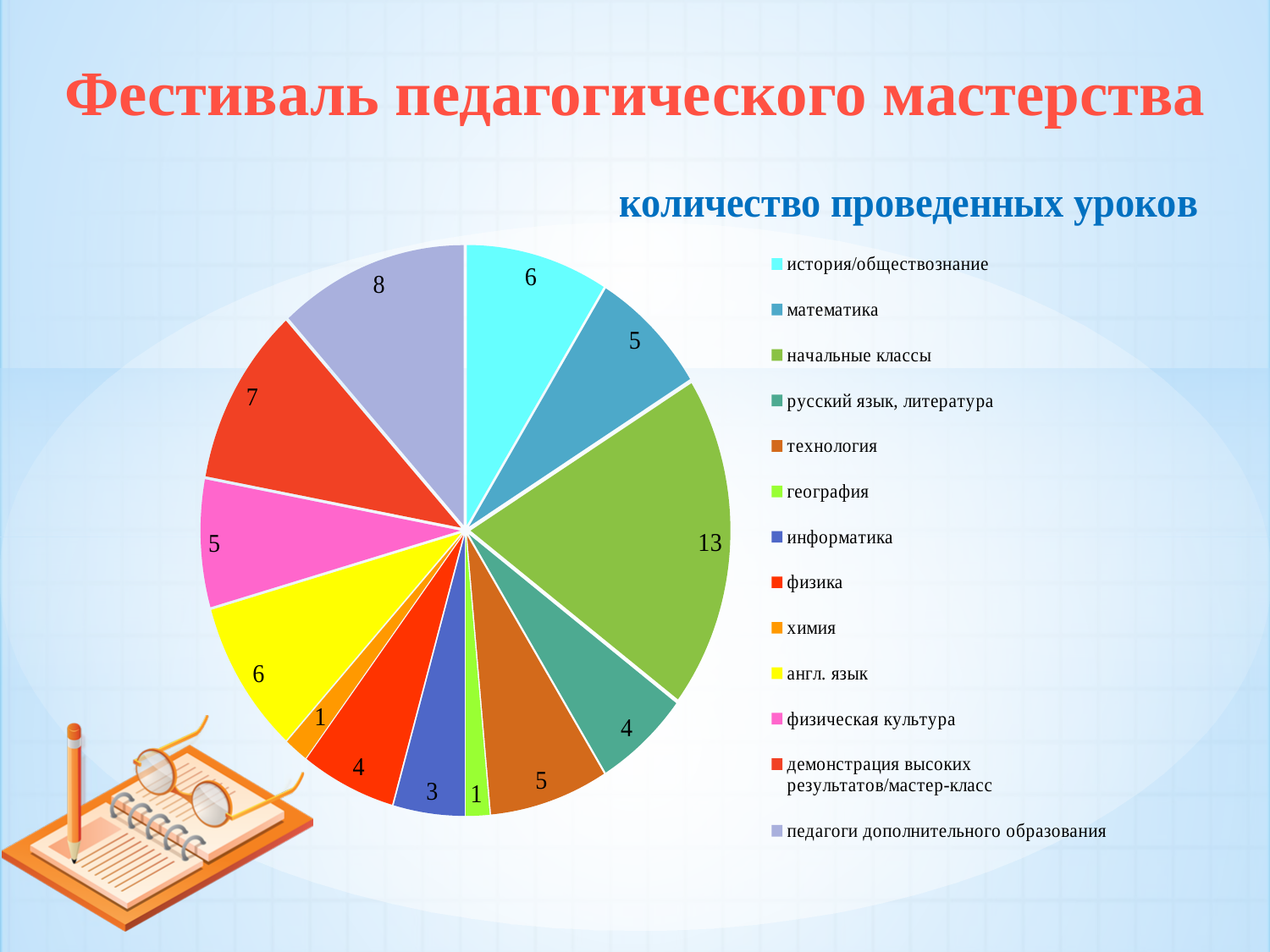
What is the difference between the values for начальные классы and педагоги дополнительного образования? 5 What type of chart is shown on the slide? pie chart How many categories does the pie chart have? 13 What is the value for начальные классы? 13 What is the value for информатика? 3 Which categories have the smallest value? география and химия What is the title of the chart? количество проведенных уроков What is the total of all the values in the pie chart? 68 Which category has the largest slice? начальные классы Which is larger, the value for математика or the value for физика? математика What is the value for демонстрация высоких результатов/мастер-класс? 7 What is the value for педагоги дополнительного образования? 8